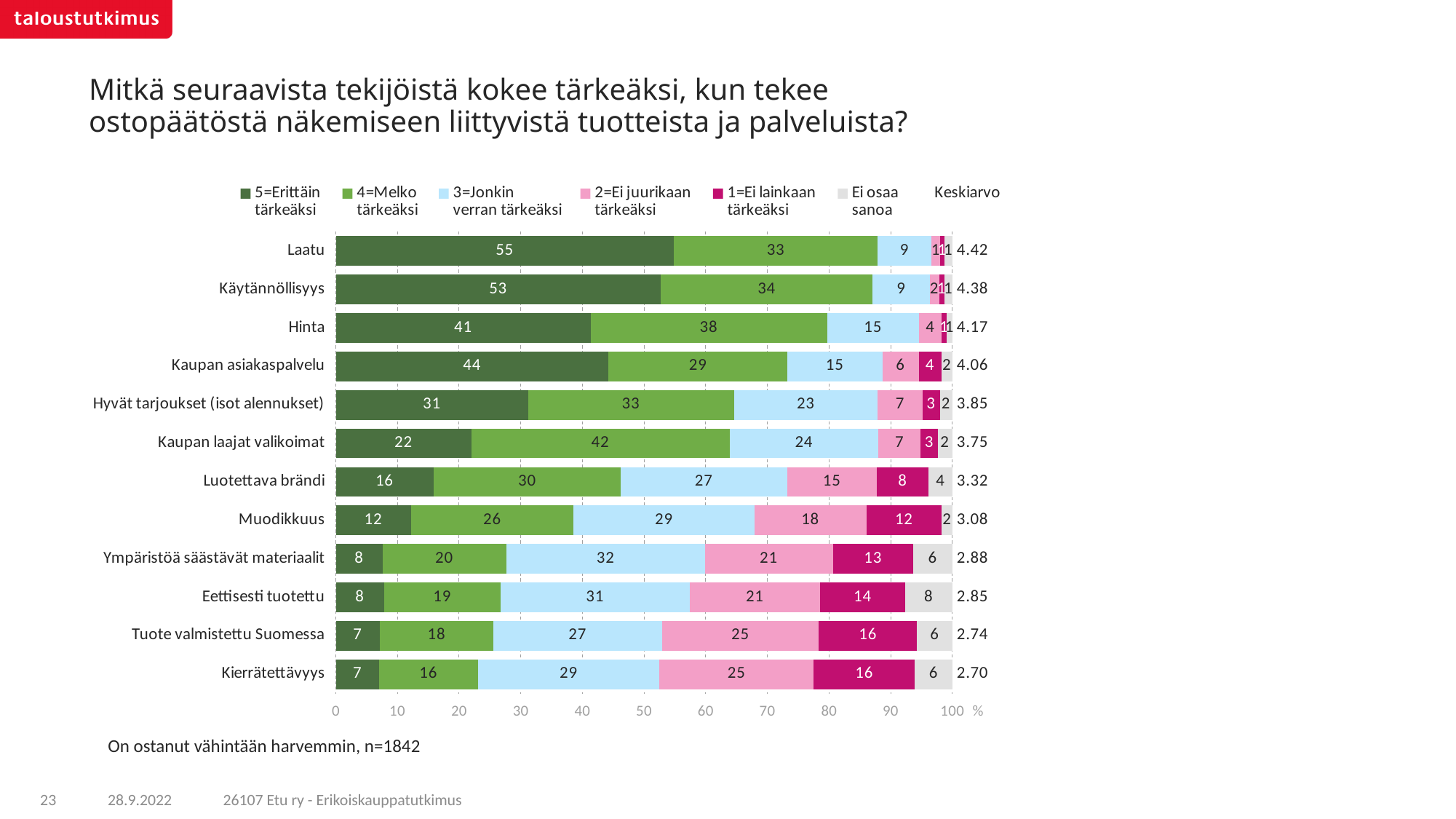
What is the value of '5=Erittäin tärkeäksi' for Laatu? 55 Which has a larger '2=Ei juurikaan tärkeäksi' value, Muodikkuus or Luotettava brändi? Muodikkuus What is the difference between the '4=Melko tärkeäksi' values for Kaupan laajat valikoimat and Luotettava brändi? 12 What is the Keskiarvo (mean) shown for Kaupan asiakaspalvelu? 4.06 What is the value of '1=Ei lainkaan tärkeäksi' for Tuote valmistettu Suomessa? 16 Which category has the highest Keskiarvo (mean)? Laatu What is the sample size (n) stated below the chart? n=1842 Which category has the lowest Keskiarvo (mean)? Kierrätettävyys What type of chart is shown on the slide? Stacked bar chart How many categories (factors) are listed on the chart? 12 What is the value of '3=Jonkin verran tärkeäksi' for Ympäristöä säästävät materiaalit? 32 What is the value of 'Ei osaa sanoa' for Eettisesti tuotettu? 8